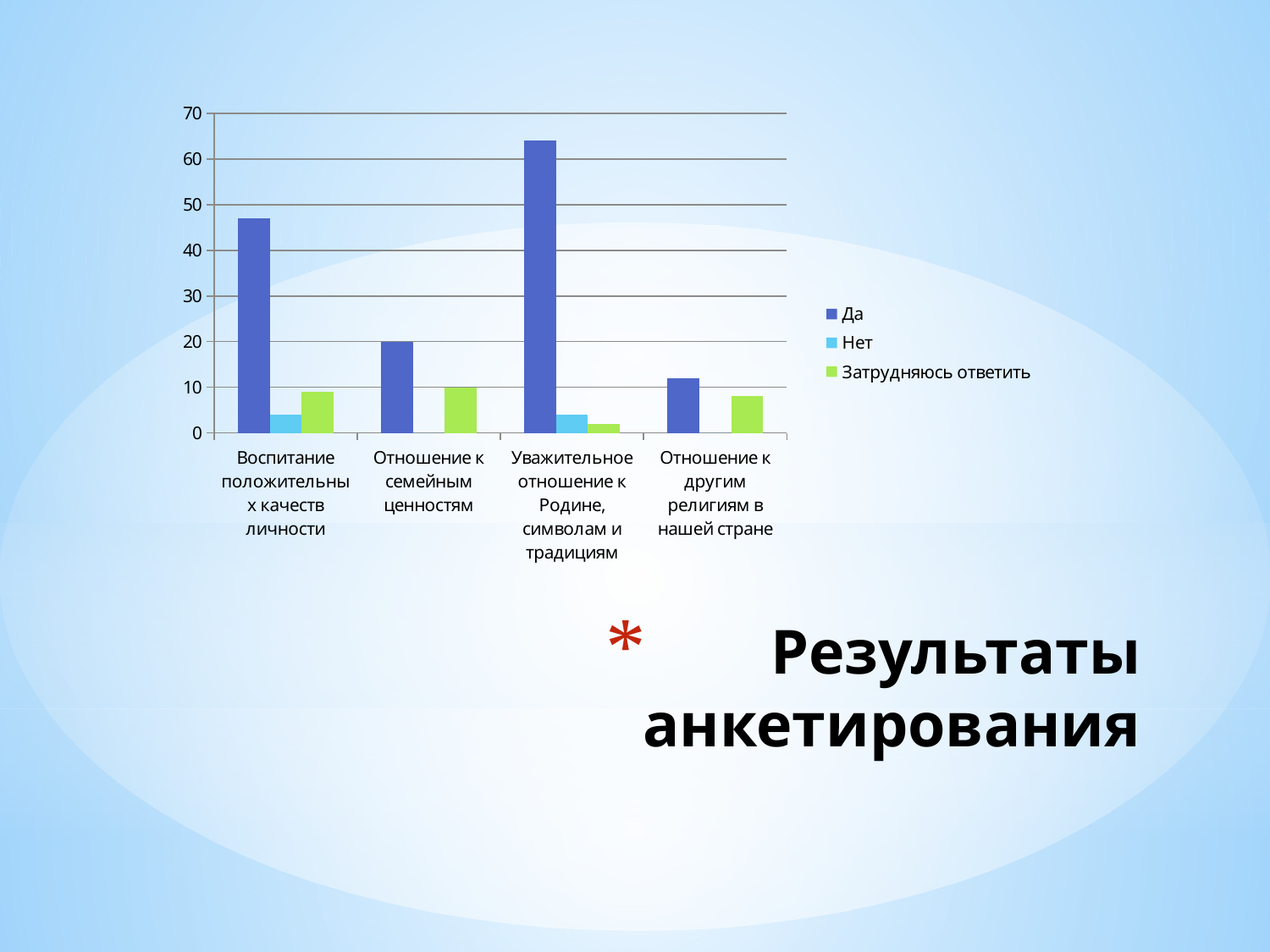
What is the value of the "Да" series for "Отношение к семейным ценностям"? 20 Which category has the lowest value for the "Да" series? Отношение к другим религиям в нашей стране Is the value of the "Да" series for "Уважительное отношение к Родине, символам и традициям" greater or less than 60? greater How many series does the chart's legend list? 3 Is the value of the "Да" series for "Воспитание положительных качеств личности" greater or less than 40? greater What kind of chart is shown on the slide? bar chart Which series is shown in green in the chart's legend? Затрудняюсь ответить Which is larger for "Уважительное отношение к Родине, символам и традициям": the "Нет" value or the "Затрудняюсь ответить" value? Нет How many categories are shown on the x axis of the chart? 4 Which category has the highest value for the "Да" series? Уважительное отношение к Родине, символам и традициям Is the value of the "Нет" series for "Воспитание положительных качеств личности" greater or less than 10? less What is the value of the "Затрудняюсь ответить" series for "Отношение к семейным ценностям"? 10